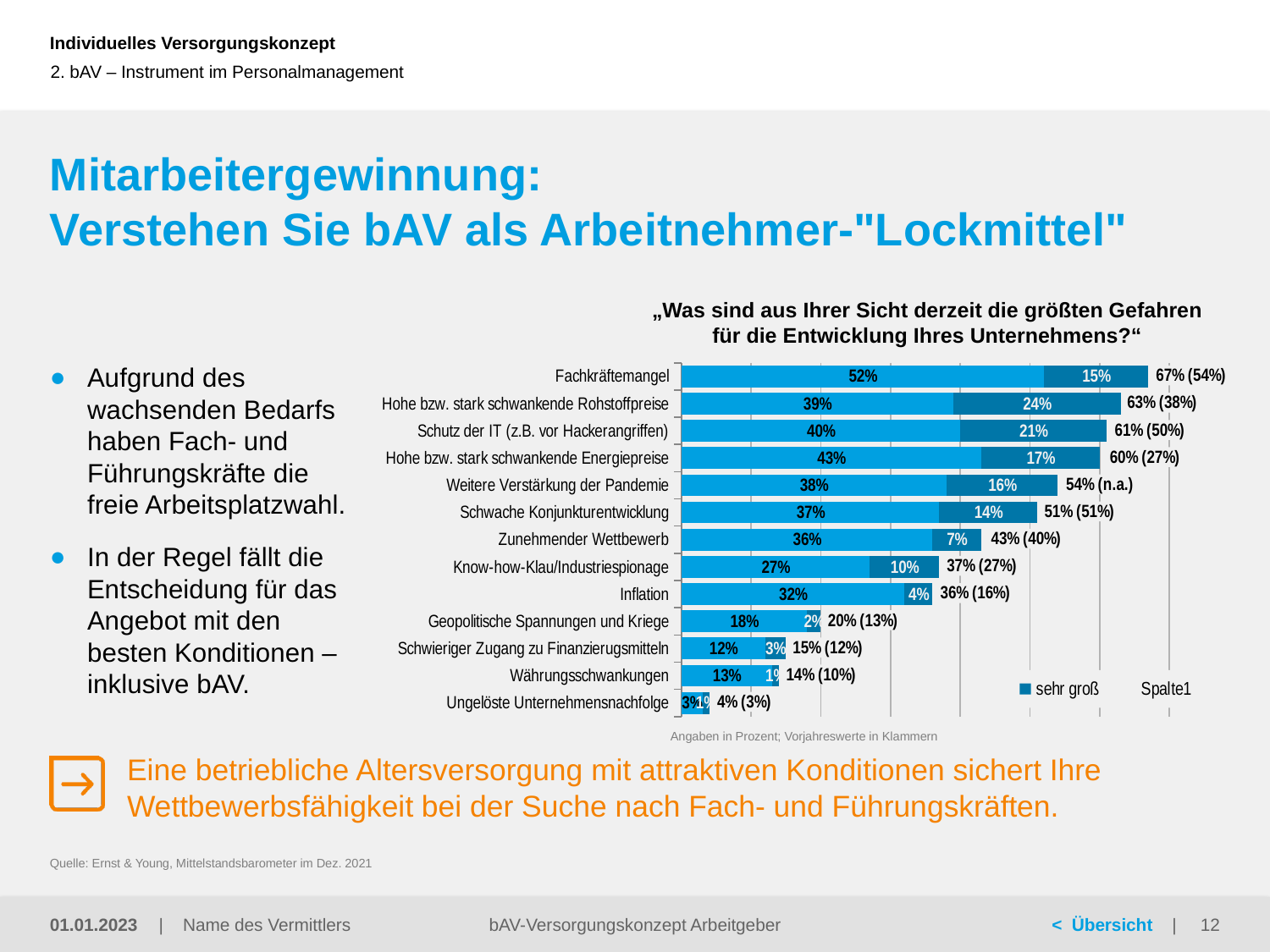
What is the 'sehr groß' segment value for Hohe bzw. stark schwankende Rohstoffpreise? 24% Which has a larger total value: Weitere Verstärkung der Pandemie or Schwache Konjunkturentwicklung? Weitere Verstärkung der Pandemie What is the total value shown for Inflation? 36% (16%) How many entries does the chart legend list? 2 Which category has the lowest total value? Ungelöste Unternehmensnachfolge What kind of chart is shown on the slide? Stacked bar chart What is the difference between the total values for Fachkräftemangel (67%) and Zunehmender Wettbewerb (43%)? 24 percentage points How many categories (risks) are listed in the chart? 13 What is the light blue segment value for Schutz der IT (z.B. vor Hackerangriffen)? 40% What is the total value shown for Fachkräftemangel? 67% (54%) What is the title (question) shown above the chart? „Was sind aus Ihrer Sicht derzeit die größten Gefahren für die Entwicklung Ihres Unternehmens?“ Which category has the highest total value? Fachkräftemangel